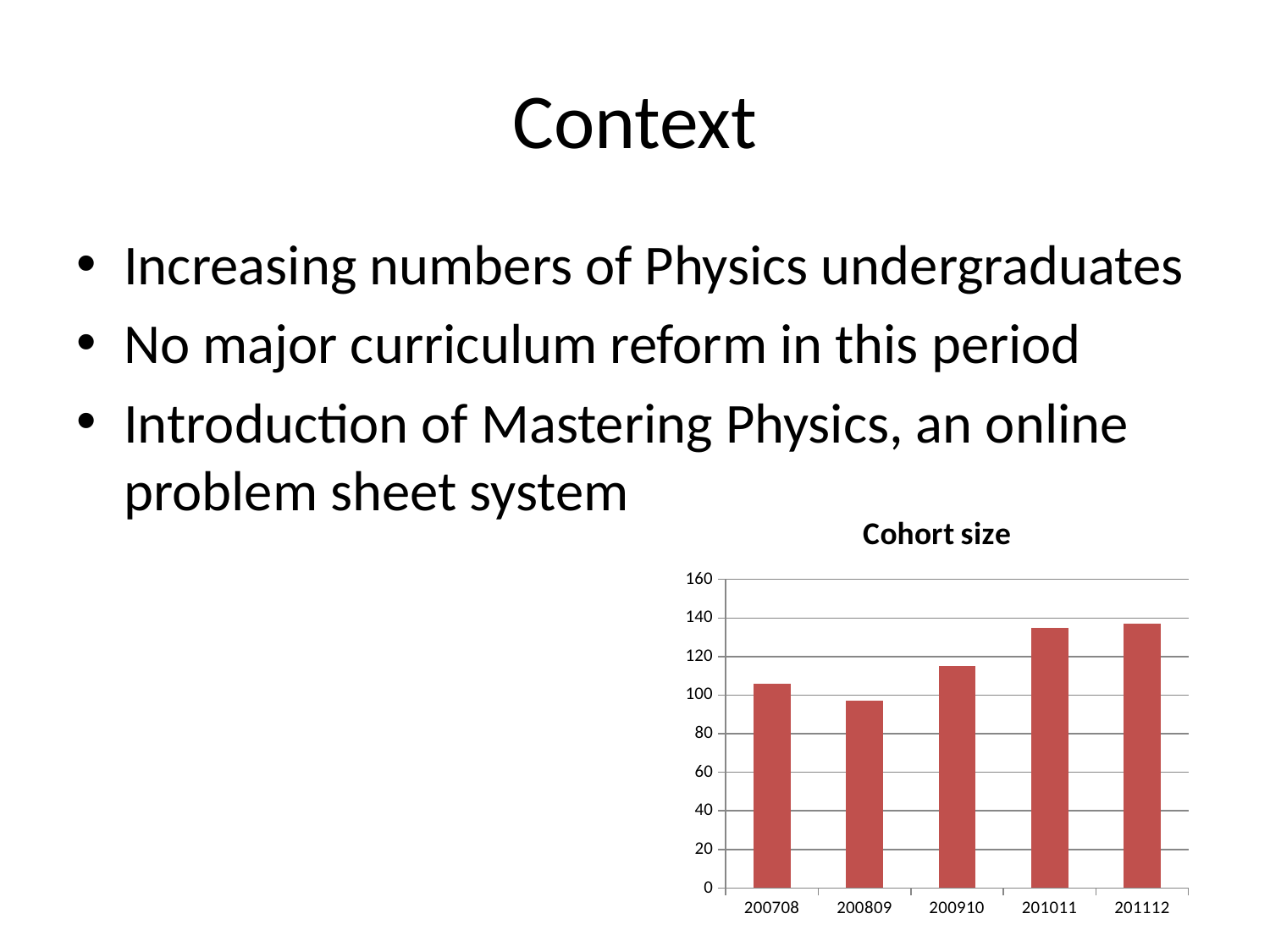
Is the value for 200809 greater or less than 100? less Which is larger, the value for 200910 or the value for 201011? 201011 Is the value for 200910 greater or less than 120? less How many categories are plotted on the x axis of the Cohort size chart? 5 What kind of chart is shown on the slide? bar chart Do the values rise or fall from 200809 to 201112? rise Is the value for 201011 greater or less than 120? greater Which category has the lowest value in the Cohort size chart? 200809 Which is larger, the value for 200708 or the value for 200809? 200708 What is the title of the chart? Cohort size